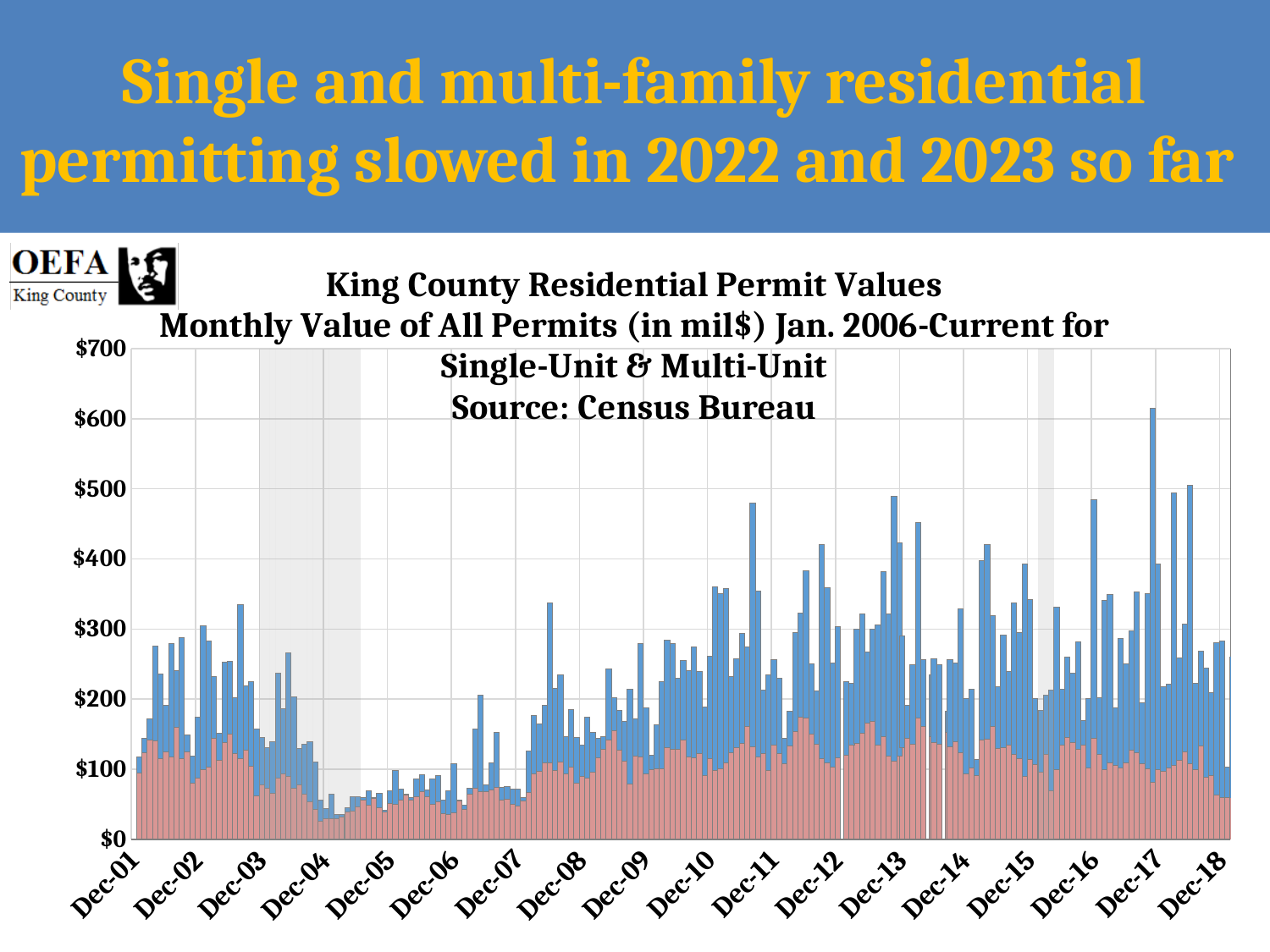
Around which x-axis label does the tallest bar in the chart appear? Dec-17 Are the bars around Dec-05 greater or less than $200? less Are the monthly permit values around Dec-04 greater or less than $100? less What source is cited for the chart's data? Census Bureau Which period has larger monthly permit values, around Dec-17 or around Dec-04? Dec-17 Is the tallest bar in the chart greater or less than $500? greater What kind of chart is shown on the slide? bar chart What is the title of the chart? King County Residential Permit Values Monthly Value of All Permits (in mil$) Jan. 2006-Current for Single-Unit & Multi-Unit Source: Census Bureau How many year labels are shown on the x axis? 18 What is the highest value shown on the y axis? $700 Do the monthly permit values generally rise or fall from Dec-04 to Dec-17? rise